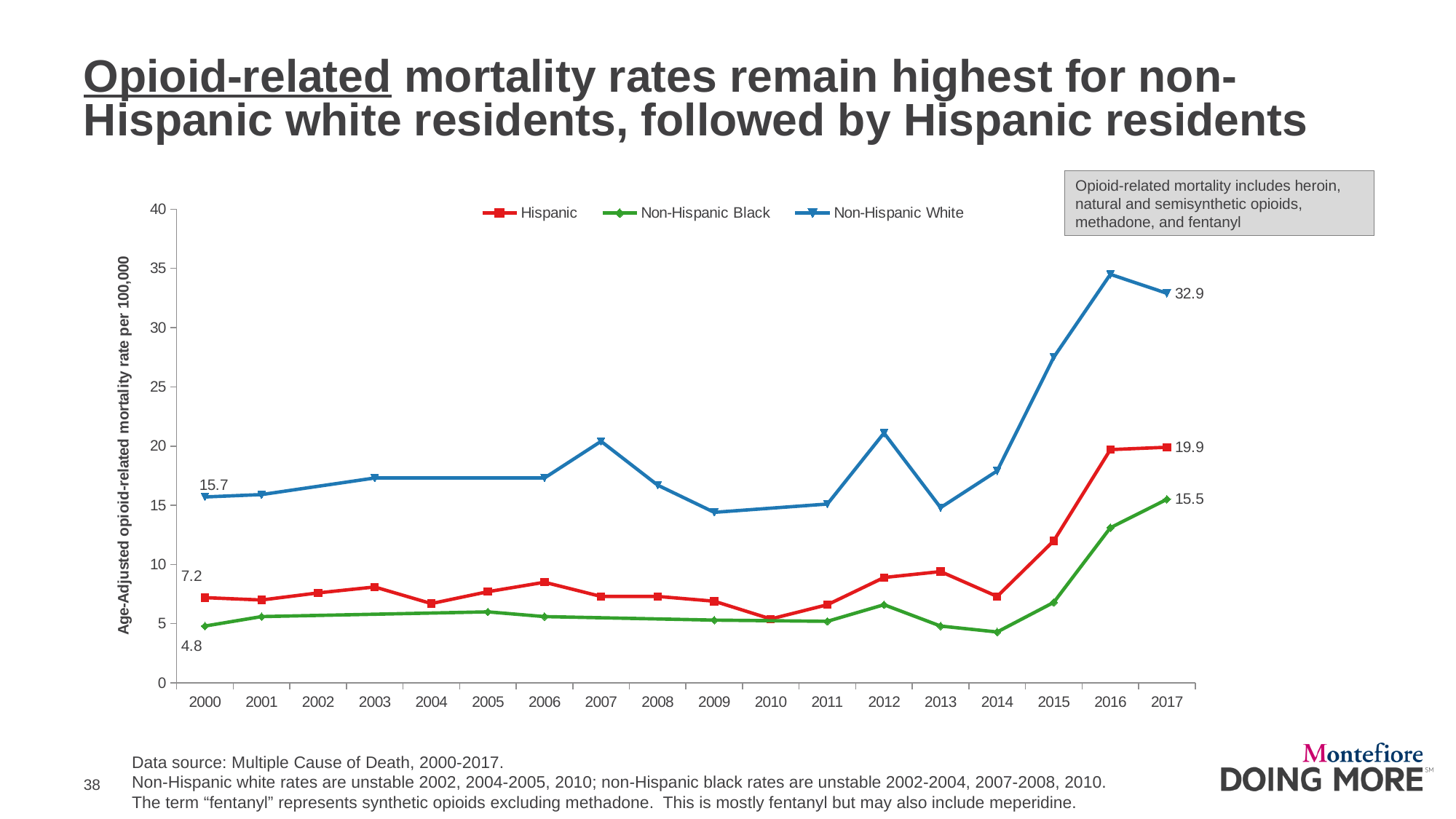
How many years are shown on the x axis? 18 What is the difference between the Non-Hispanic White and Hispanic mortality rates in 2017? 13.0 What is the Non-Hispanic White opioid-related mortality rate in 2000? 15.7 What is the Hispanic opioid-related mortality rate in 2000? 7.2 What type of chart is shown on the slide? line chart Which group had the highest opioid-related mortality rate in 2017? Non-Hispanic White How many series does the legend list? 3 Is the Non-Hispanic White mortality rate in 2016 greater or less than 30? greater Which group had the lowest opioid-related mortality rate in 2000? Non-Hispanic Black What is the Non-Hispanic Black opioid-related mortality rate in 2017? 15.5 What is the Non-Hispanic White opioid-related mortality rate in 2017? 32.9 By how much did the Hispanic mortality rate change from 2000 to 2017? 12.7